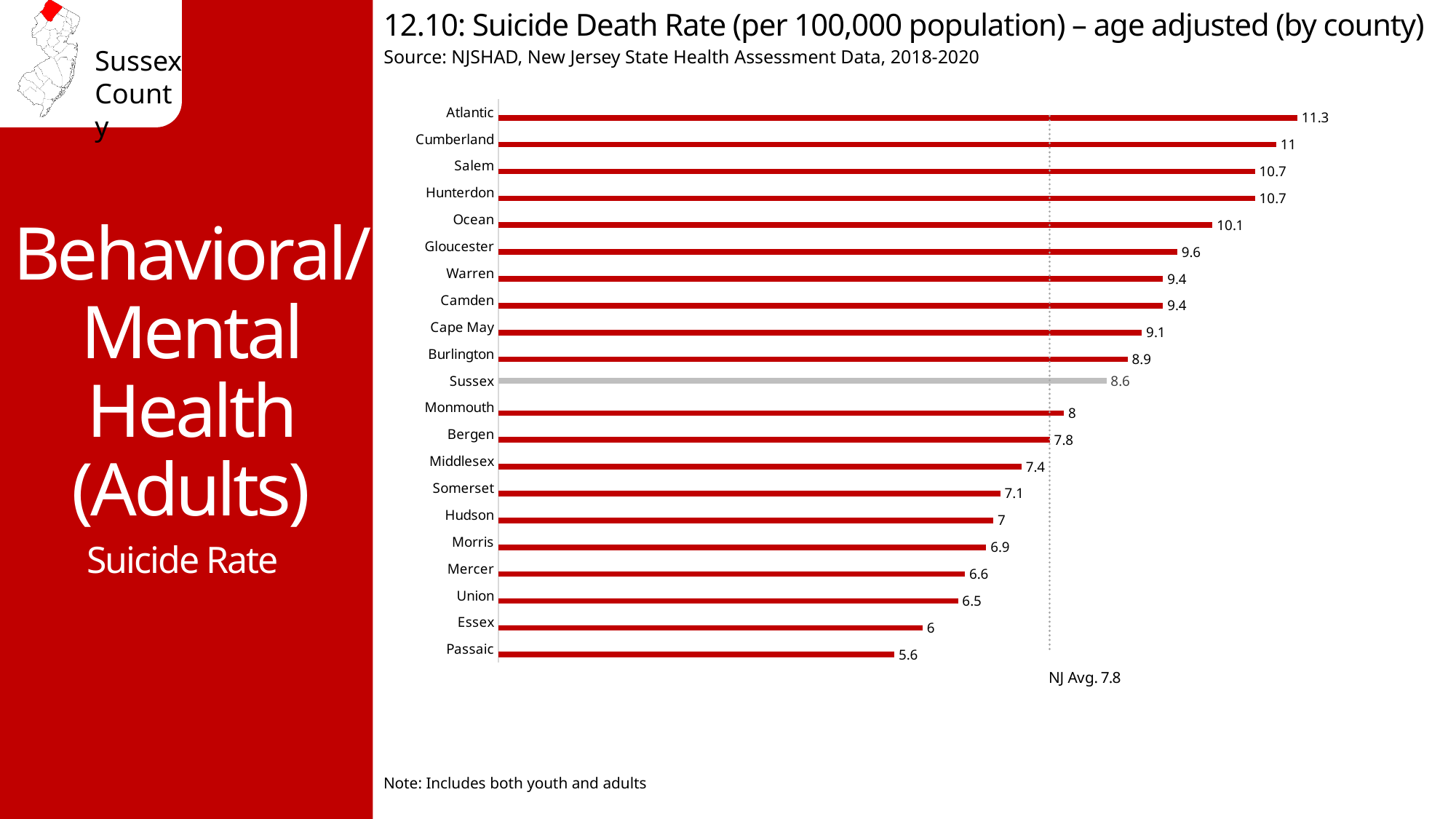
Which county has the lowest suicide death rate? Passaic What is the suicide death rate for Sussex County? 8.6 Which county's bar is shown in gray instead of red? Sussex What is the NJ average suicide death rate marked by the dotted line? 7.8 What is the suicide death rate for Passaic County? 5.6 How much higher is Sussex County's suicide death rate than the NJ average of 7.8? 0.8 What type of chart is used on this slide? Bar chart Which county has a higher suicide death rate, Ocean or Gloucester? Ocean How many counties are shown in the chart? 21 What is the difference between the suicide death rates of Atlantic and Passaic counties? 5.7 Which county has the highest suicide death rate? Atlantic What is the suicide death rate for Atlantic County? 11.3